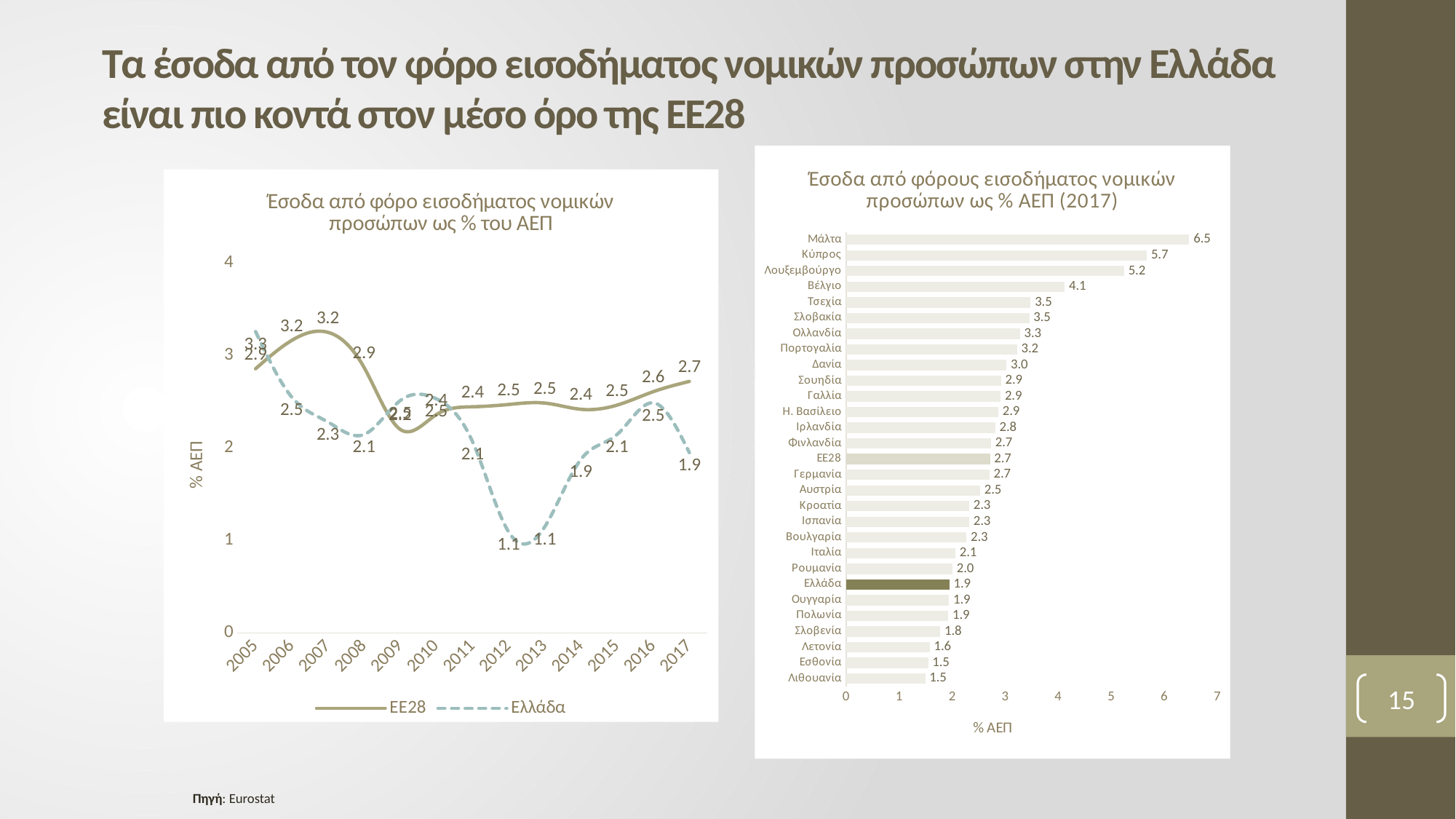
What kind of chart is the right chart (2017 by country)? Bar chart In the left chart (line chart), what is the value for ΕΕ28 in 2017? 2.7 In the right chart (2017 bar chart), what is the value for Ελλάδα? 1.9 In the left chart (line chart), which series is drawn with a dashed line? Ελλάδα In the left chart (line chart), how many series does the legend list? 2 In the right chart (2017 bar chart), which has the larger value, Ολλανδία or Δανία? Ολλανδία In the left chart (line chart), what is the difference between ΕΕ28 and Ελλάδα in 2017? 0.8 In the left chart (Έσοδα από φόρο εισοδήματος νομικών προσώπων ως % του ΑΕΠ), what is the value for Ελλάδα in 2012? 1.1 In the right chart (2017 bar chart), how many bars are plotted? 29 In the right chart (Έσοδα από φόρους εισοδήματος νομικών προσώπων ως % ΑΕΠ (2017)), what is the value for Μάλτα? 6.5 In the right chart (2017 bar chart), what is the difference between the values for Κύπρος and Βέλγιο? 1.6 In the right chart (2017 bar chart), which country has the highest value? Μάλτα